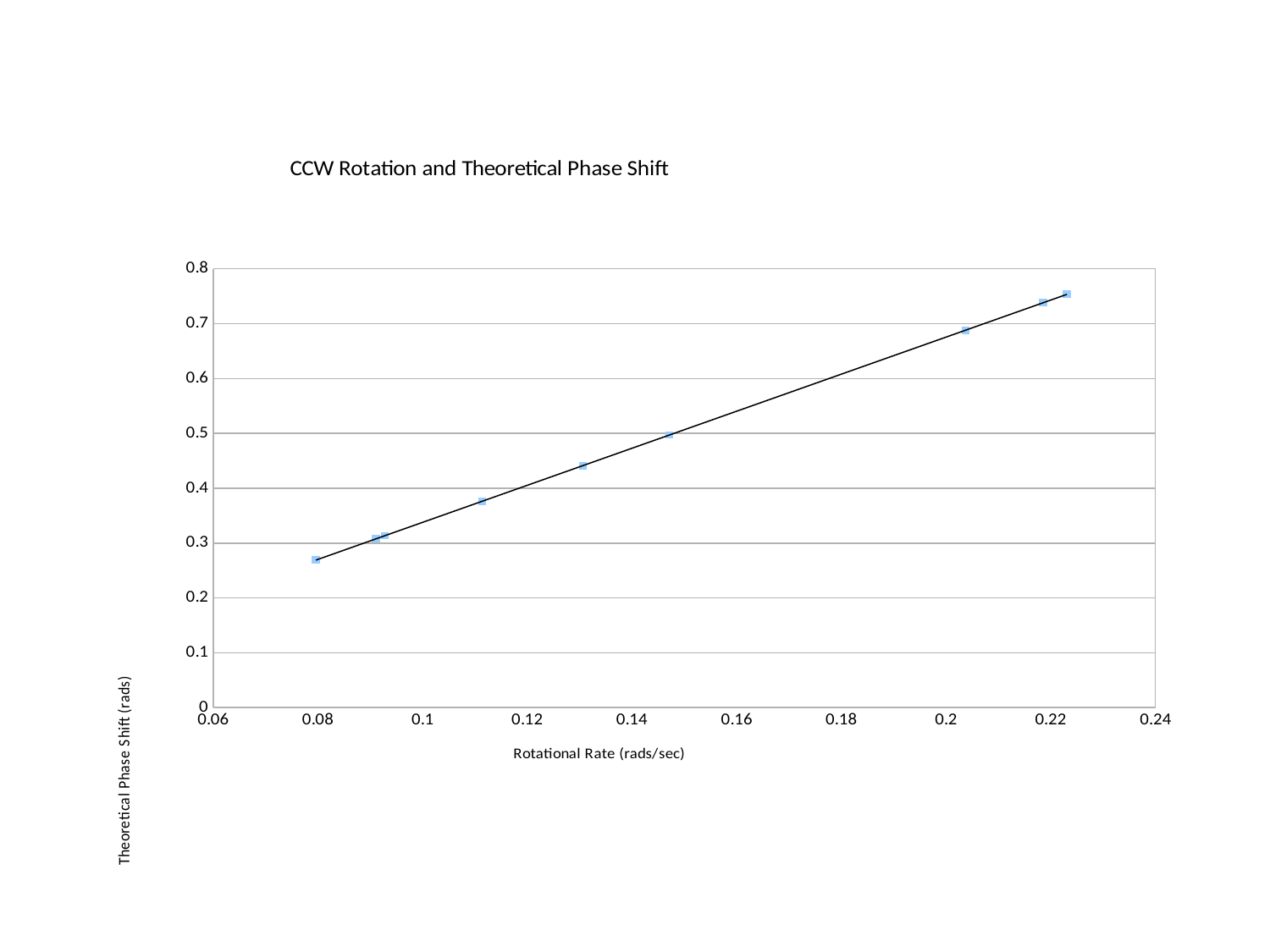
What is the title of the chart? CCW Rotation and Theoretical Phase Shift Is the theoretical phase shift for the point at a rotational rate of about 0.22 rads/sec greater or less than 0.7? greater What kind of chart is shown on the slide? Scatter chart Do the plotted values rise or fall as the rotational rate increases? Rise What is the label of the x axis? Rotational Rate (rads/sec) Is the theoretical phase shift at a rotational rate of about 0.08 rads/sec larger or smaller than at about 0.13 rads/sec? Smaller Is the theoretical phase shift for the point at a rotational rate of about 0.08 rads/sec greater or less than 0.3? less Which plotted point has the highest theoretical phase shift: the one at the lowest rotational rate or the one at the highest rotational rate? The one at the highest rotational rate What is the maximum value shown on the y axis? 0.8 Is the theoretical phase shift for the point at a rotational rate of about 0.11 rads/sec greater or less than 0.4? less